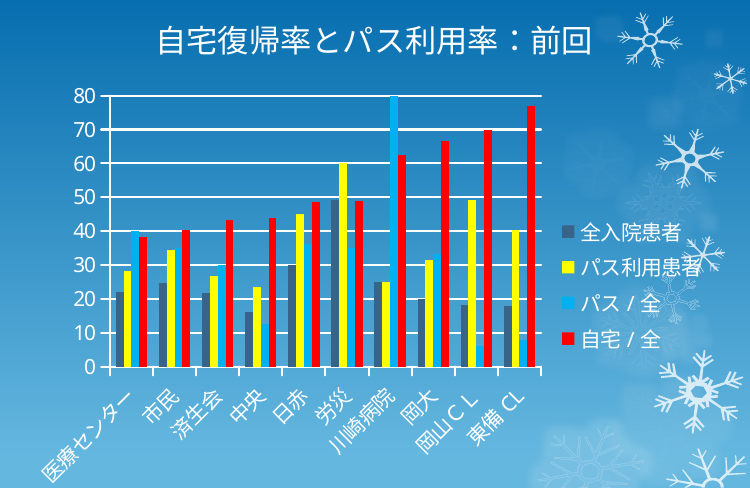
What is the title of the chart? 自宅復帰率とパス利用率：前回 Is the value of 自宅 / 全 for 岡大 greater or less than 60? greater How many categories are shown along the x axis? 10 Which category has the highest value for 自宅 / 全? 東備 CL Is the value of 自宅 / 全 for 東備 CL greater or less than 70? greater How many series does the legend list? 4 Which category has the highest value for パス / 全? 川崎病院 Is the value of パス / 全 for 東備 CL greater or less than 20? less Do the 自宅 / 全 values generally rise or fall from left to right along the x axis? rise Which is larger: the 自宅 / 全 value for 東備 CL or for 医療センター? 東備 CL What kind of chart is shown on the slide? bar chart